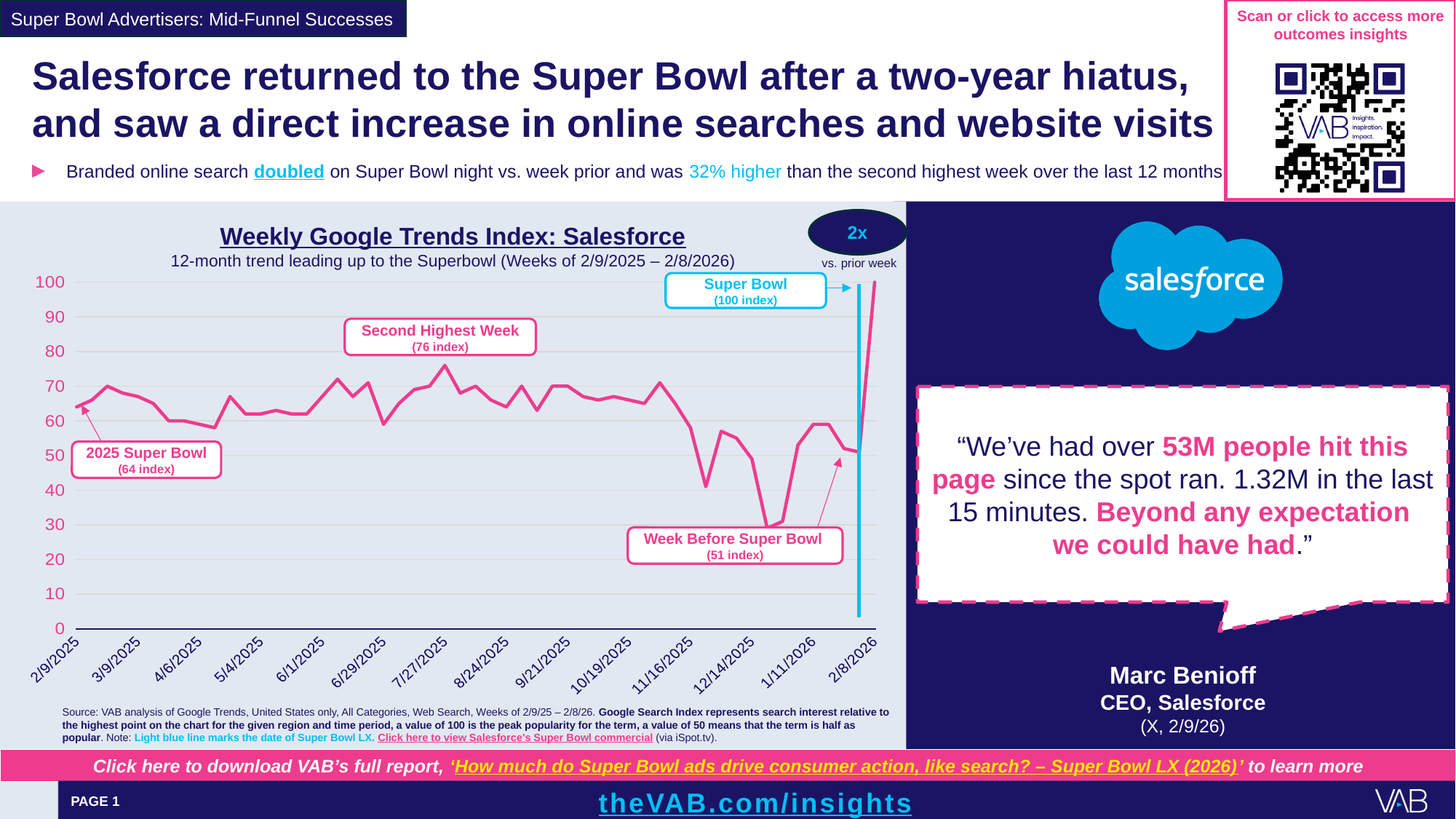
How much higher is the Super Bowl week index than the Second Highest Week index? 24 What is the Google Trends index value for the Super Bowl week (2/8/2026)? 100 What index value is labeled for the Second Highest Week? 76 Is the lowest point on the line (the dip in late December 2025) greater or less than 40? less Which is larger: the 2025 Super Bowl week index or the Week Before Super Bowl index? 2025 Super Bowl week What is the difference between the 2026 Super Bowl week index (100) and the 2025 Super Bowl week index (64)? 36 What index value is labeled for the 2025 Super Bowl week? 64 What is the title of the chart? Weekly Google Trends Index: Salesforce What index value is labeled for the Week Before Super Bowl? 51 What kind of chart is shown on the slide? Line chart What is the difference between the Super Bowl week index and the Week Before Super Bowl index? 49 Which week has the highest Google Trends index on the chart? Super Bowl week (2/8/2026)